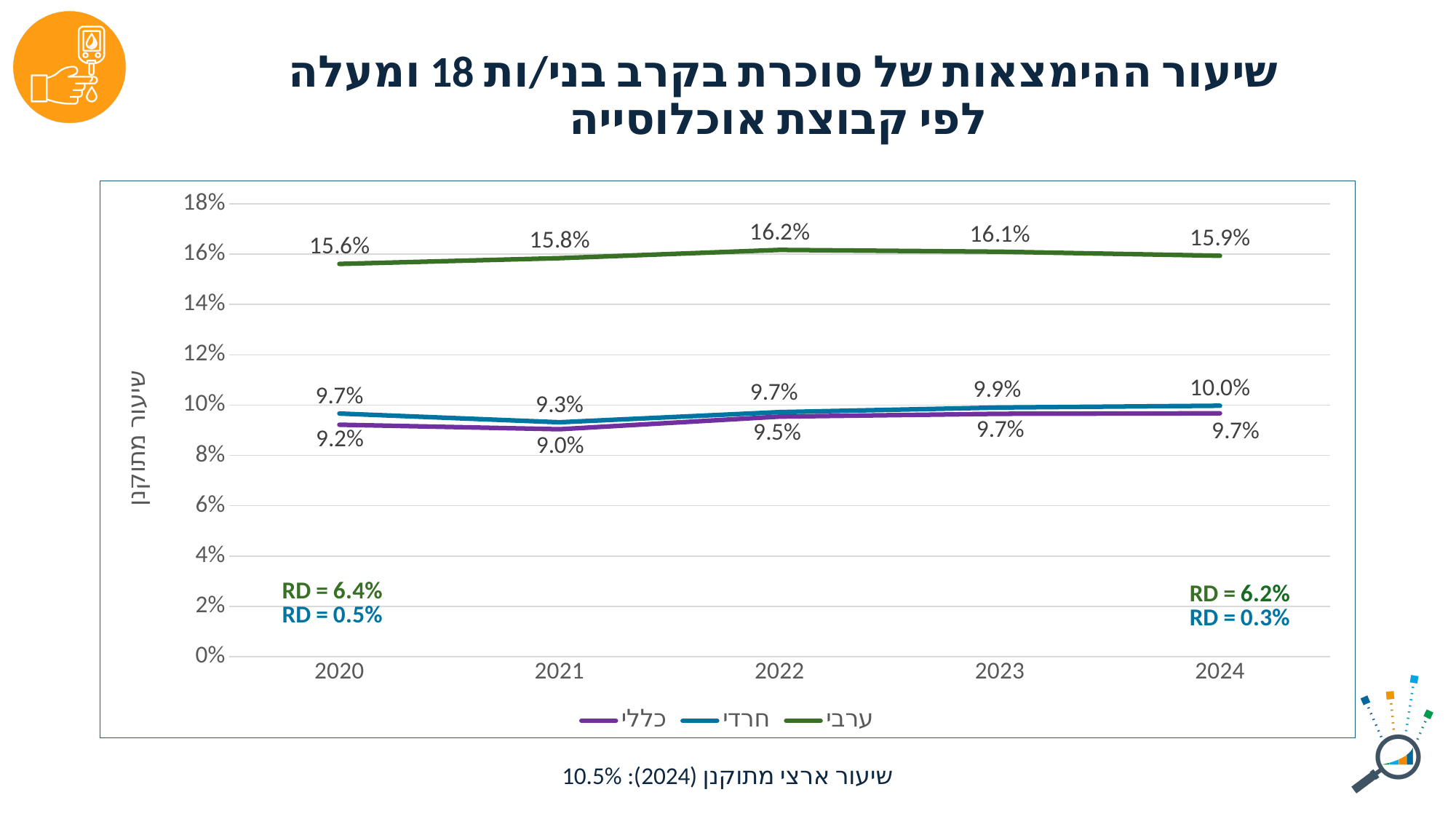
How many series does the legend list? 3 What is the value for the חרדי series in 2024? 10.0% What is the difference between the ערבי and כללי values in 2020? 6.4% In which year is the ערבי series at its highest? 2022 What is the value for the ערבי series in 2022? 16.2% What type of chart is shown on the slide? line chart Does the חרדי series rise or fall from 2021 to 2024? rise What is the value for the כללי series in 2021? 9.0% How many years are plotted on the x axis? 5 In which year is the כללי series at its lowest? 2021 Which series has the higher value in 2023, חרדי or כללי? חרדי What colour is the line for the ערבי series? green